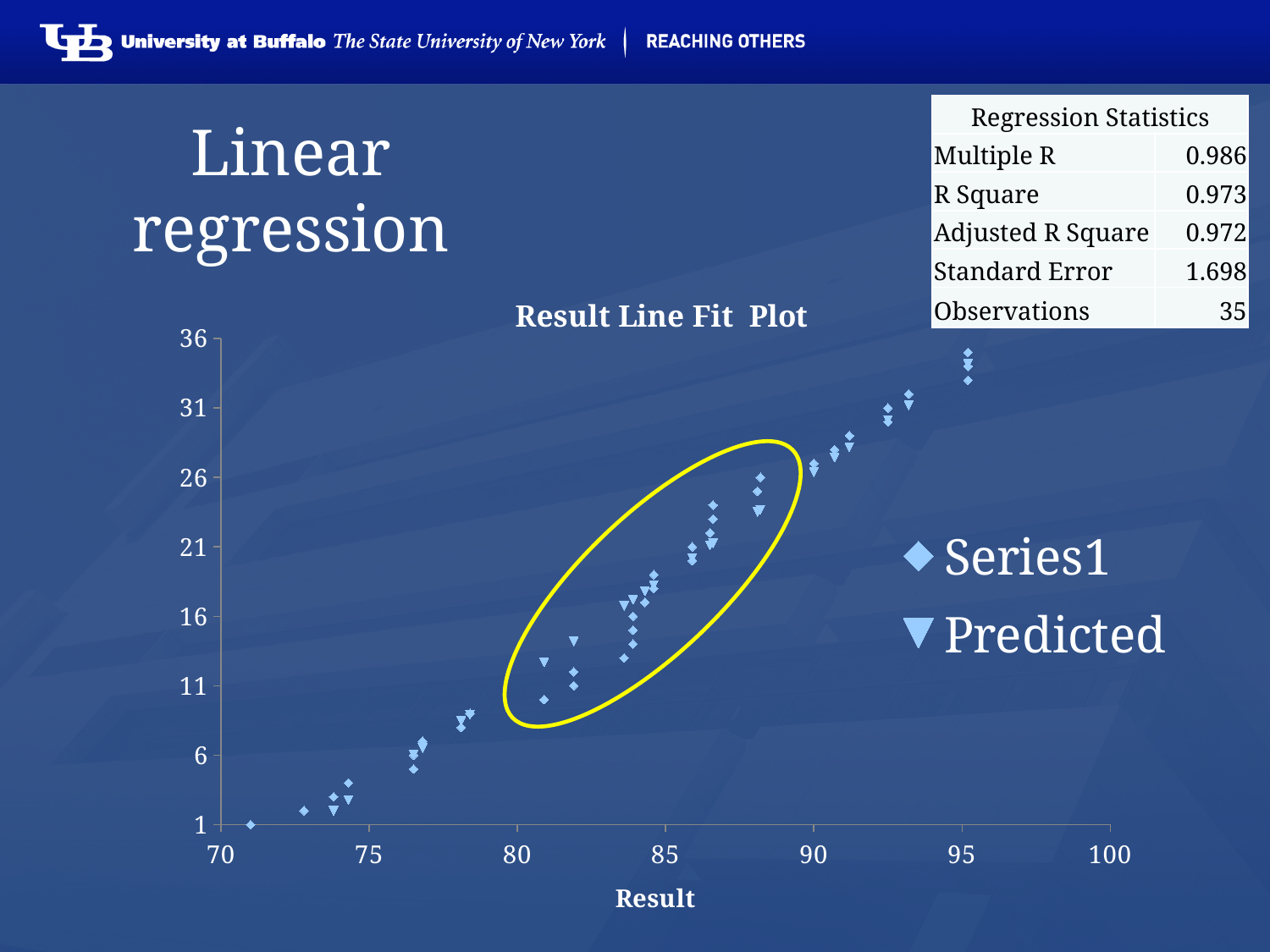
In the Result Line Fit Plot, are the values plotted at a Result of about 78 greater or less than 11? less What is the title of the chart on the slide? Result Line Fit Plot In the Result Line Fit Plot, are the values plotted at a Result of about 90 greater or less than 21? greater In the Result Line Fit Plot, are the values plotted at a Result of about 95 greater or less than 31? greater In the Result Line Fit Plot, do the plotted values rise or fall as Result increases along the x axis? rise What kind of chart is the Result Line Fit Plot? scatter chart What are the two series named in the legend of the Result Line Fit Plot? Series1 and Predicted How many series does the legend of the Result Line Fit Plot list? 2